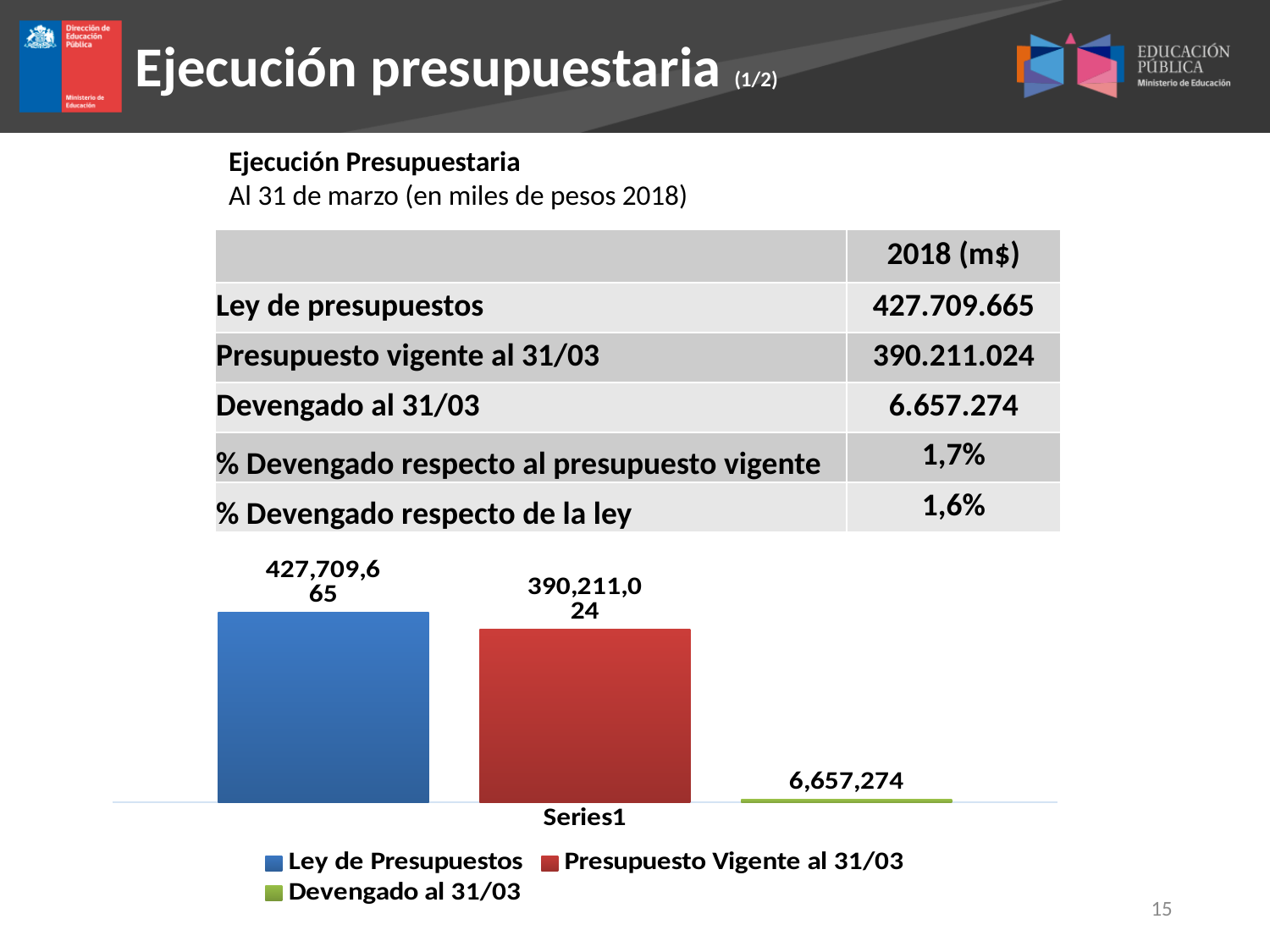
What colour is the bar for Presupuesto Vigente al 31/03? Red Which series has the lowest value in the chart? Devengado al 31/03 What value is shown for Presupuesto Vigente al 31/03 in the chart? 390,211,024 What is the difference between Presupuesto Vigente al 31/03 and Devengado al 31/03 in the chart? 383,553,750 What is the difference between Ley de Presupuestos and Presupuesto Vigente al 31/03 in the chart? 37,498,641 What value is shown for Devengado al 31/03 in the chart? 6,657,274 What value is shown for Ley de Presupuestos in the chart? 427,709,665 What kind of chart is shown on the slide? Bar chart Which is larger in the chart, Presupuesto Vigente al 31/03 or Devengado al 31/03? Presupuesto Vigente al 31/03 What is the label shown on the category axis of the chart? Series1 Which series has the highest value in the chart? Ley de Presupuestos How many series does the chart legend list? 3